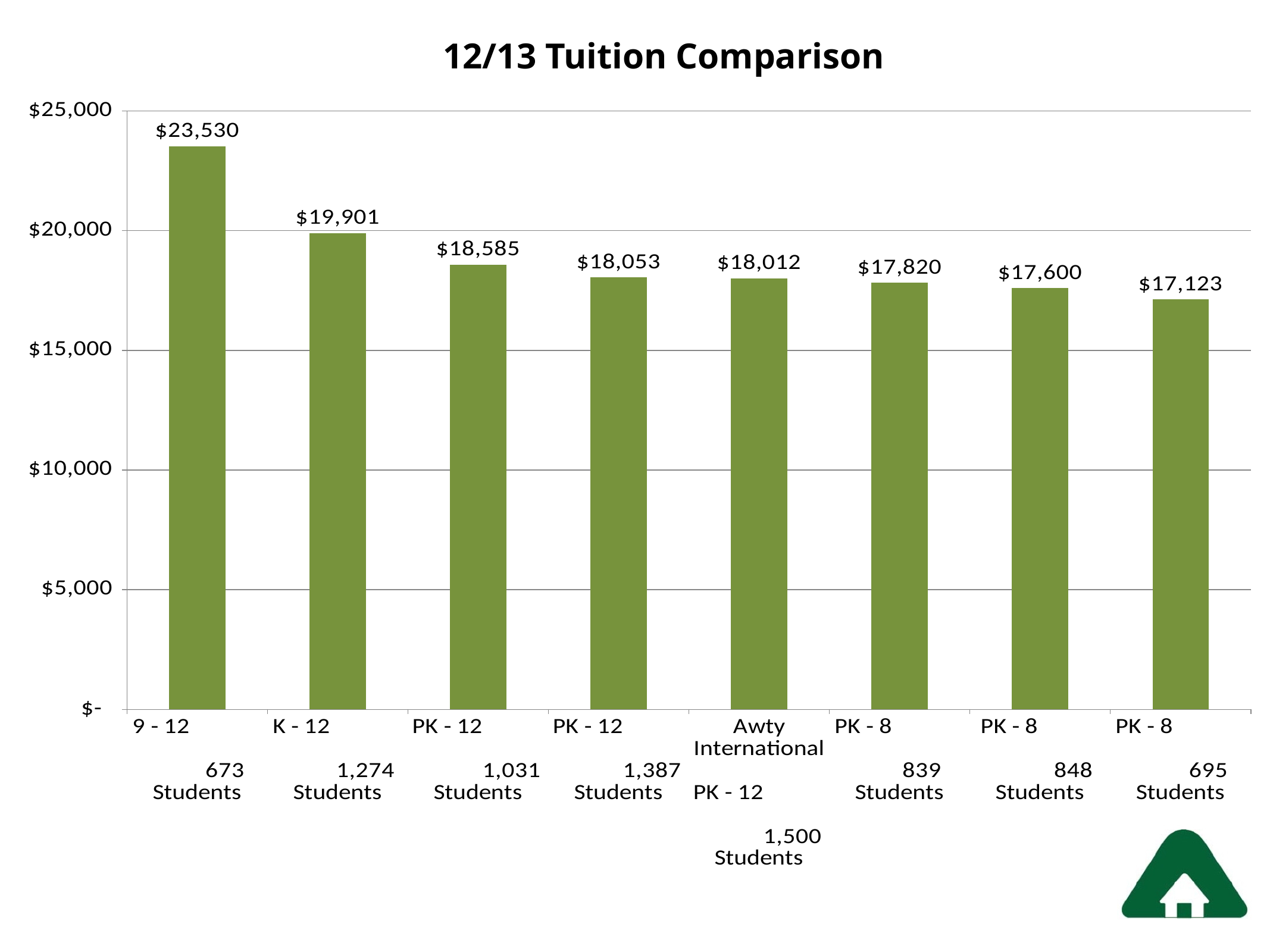
What is the tuition shown for the PK - 8 school with 695 students? $17,123 Which school has the highest tuition in the chart? 9 - 12 (673 Students) What is the difference in tuition between the 9 - 12 school (673 students) and the K - 12 school (1,274 students)? $3,629 What is the tuition shown for Awty International (PK - 12, 1,500 students)? $18,012 What is the tuition shown for the K - 12 school with 1,274 students? $19,901 What is the title of the chart? 12/13 Tuition Comparison Which school has the lowest tuition in the chart? PK - 8 (695 Students) What is the tuition shown for the 9 - 12 school with 673 students? $23,530 How many schools (bars) are shown in the chart? 8 What type of chart is shown on the slide? bar chart Which has the higher tuition: the PK - 12 school with 1,031 students or the PK - 8 school with 839 students? PK - 12 (1,031 Students) Is the tuition for the PK - 8 school with 848 students greater or less than $20,000? less